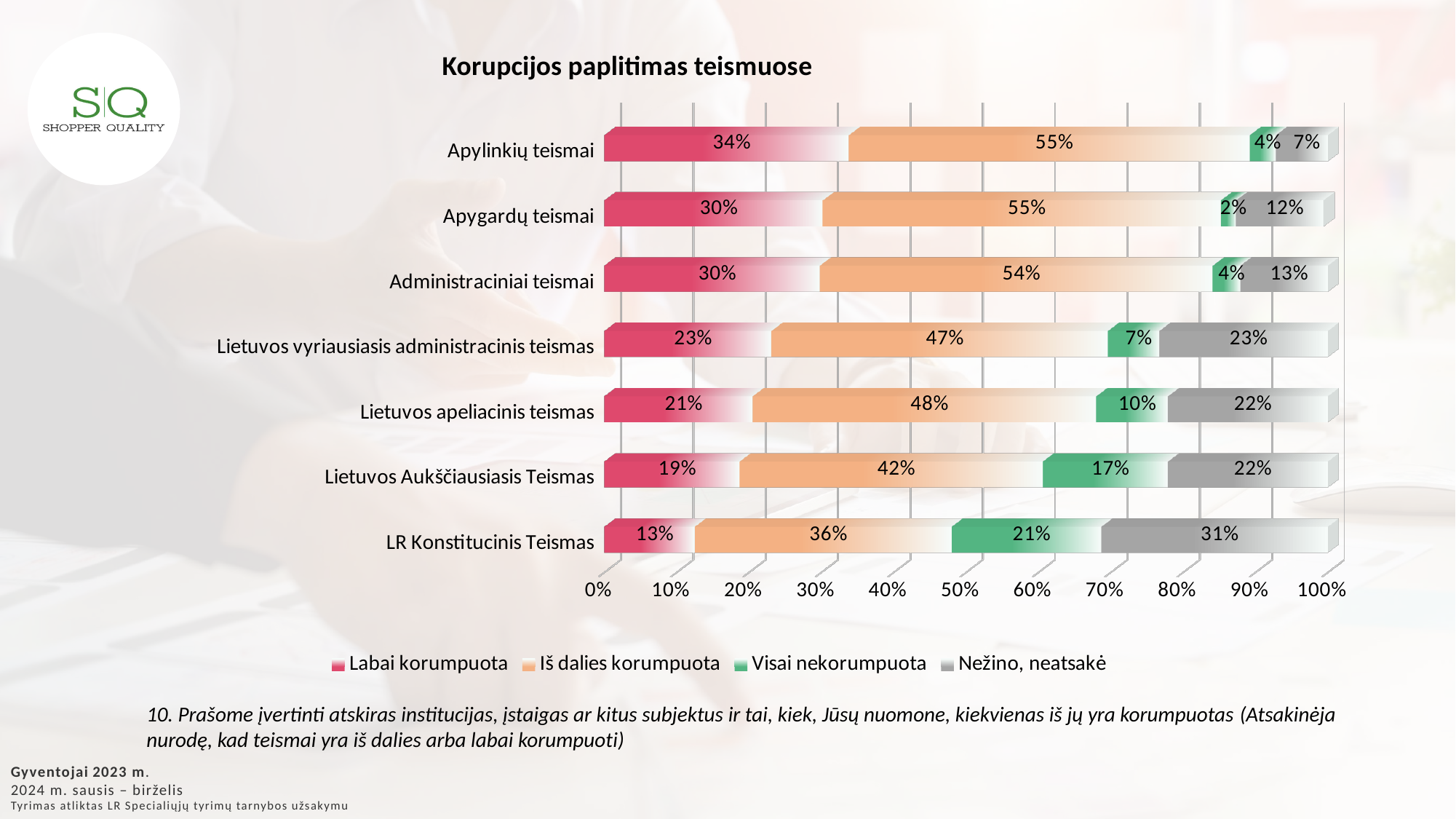
What is the 'Nežino, neatsakė' value for LR Konstitucinis Teismas? 31% What kind of chart is shown on the slide? Stacked bar chart What is the 'Visai nekorumpuota' value for Lietuvos Aukščiausiasis Teismas? 17% How many series does the legend list? 4 Which category has the lowest 'Visai nekorumpuota' value? Apygardų teismai How many categories (courts) are shown in the chart? 7 Which category has the highest 'Labai korumpuota' value? Apylinkių teismai What is the 'Labai korumpuota' value for Apylinkių teismai? 34% What is the difference between the 'Nežino, neatsakė' values for LR Konstitucinis Teismas and Apylinkių teismai? 24% Which is larger: the 'Iš dalies korumpuota' value for Lietuvos Aukščiausiasis Teismas or for Lietuvos vyriausiasis administracinis teismas? Lietuvos vyriausiasis administracinis teismas What is the 'Iš dalies korumpuota' value for Lietuvos apeliacinis teismas? 48% What is the title of the chart? Korupcijos paplitimas teismuose